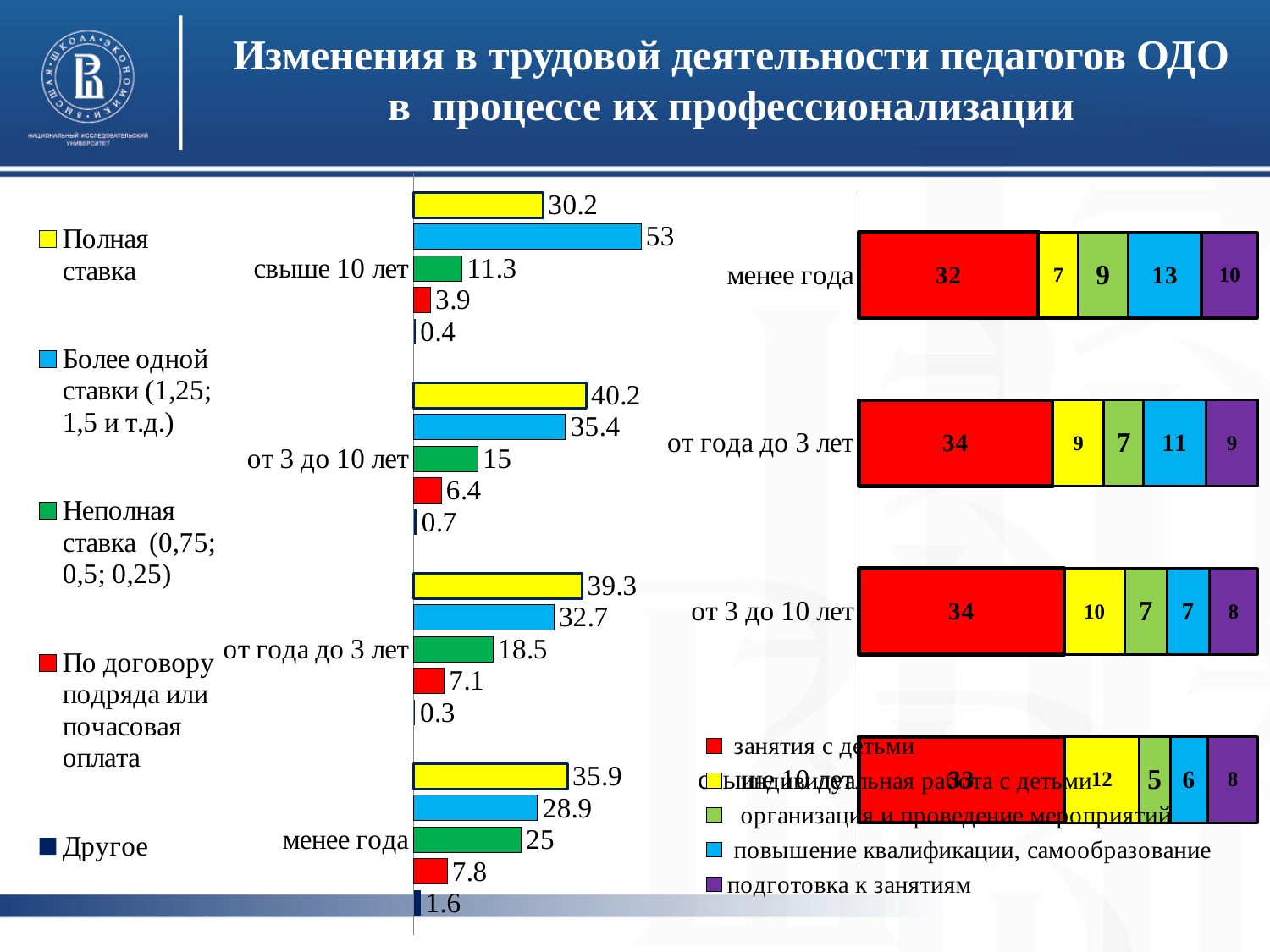
In the left chart, what is the value for Неполная ставка in the менее года group? 25 In the left chart, what is the value for Более одной ставки in the свыше 10 лет group? 53 In the left chart, what is the value for Полная ставка in the от 3 до 10 лет group? 40.2 What kind of chart is the right chart? stacked bar chart How many series does the legend of the left chart list? 5 In the right chart, which is larger in the от 3 до 10 лет bar: индивидуальная работа с детьми or подготовка к занятиям? индивидуальная работа с детьми In the left chart, which group has the lowest value for Неполная ставка? свыше 10 лет In the left chart, which is larger in the от года до 3 лет group: Полная ставка or Более одной ставки? Полная ставка In the left chart, what is the difference between Полная ставка and Более одной ставки in the менее года group? 7 In the right chart, what is the value for повышение квалификации, самообразование in the менее года bar? 13 In the right chart, what is the total of the от года до 3 лет stacked bar? 70 In the left chart, which group has the highest value for Более одной ставки? свыше 10 лет